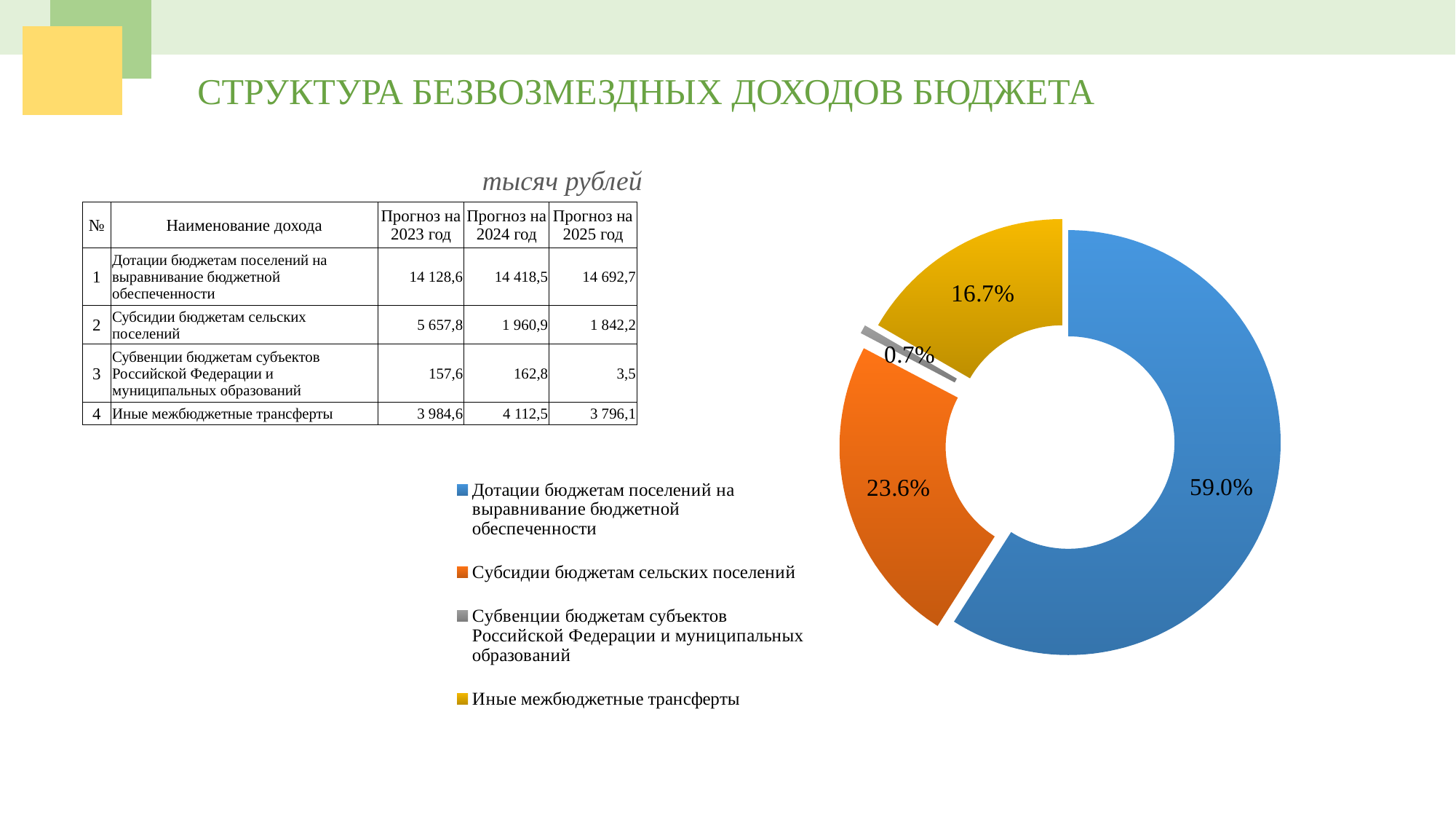
Which slice is larger: Субсидии бюджетам сельских поселений or Иные межбюджетные трансферты? Субсидии бюджетам сельских поселений Which category has the smallest slice in the doughnut chart? Субвенции бюджетам субъектов Российской Федерации и муниципальных образований What share of the doughnut chart does the slice for Дотации бюджетам поселений на выравнивание бюджетной обеспеченности represent? 59.0% How many slices does the doughnut chart have? 4 What share of the doughnut chart does the slice for Иные межбюджетные трансферты represent? 16.7% How many entries does the chart legend list? 4 What share of the doughnut chart does the slice for Субсидии бюджетам сельских поселений represent? 23.6% Which category has the largest slice in the doughnut chart? Дотации бюджетам поселений на выравнивание бюджетной обеспеченности What type of chart is shown on the slide? Doughnut chart What colour is the slice for Иные межбюджетные трансферты in the doughnut chart? Yellow What is the difference in percentage points between the slices for Дотации бюджетам поселений на выравнивание бюджетной обеспеченности and Субсидии бюджетам сельских поселений? 35.4